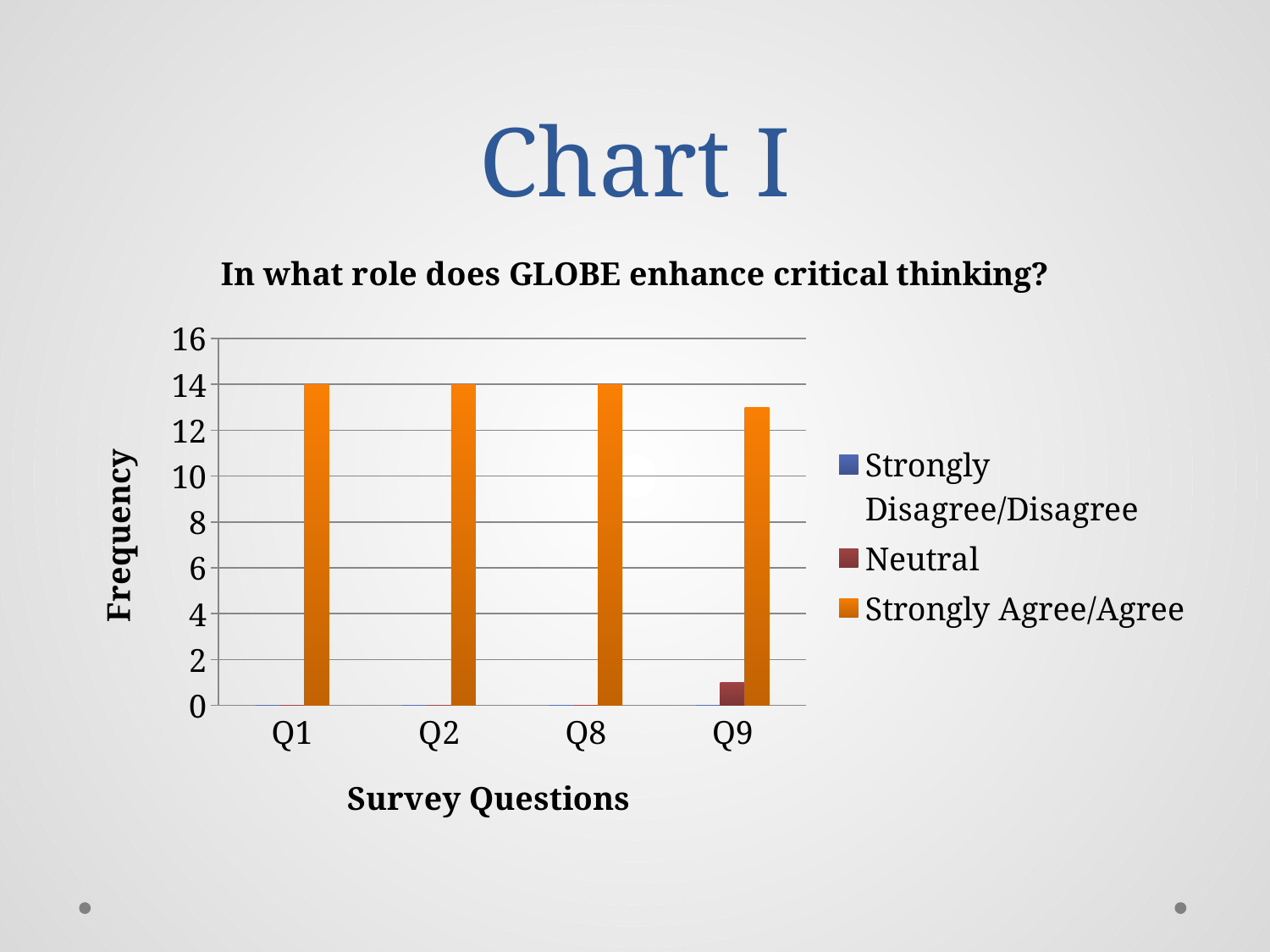
What is the label of the vertical axis? Frequency Is the Strongly Agree/Agree value for Q9 greater or less than 12? greater What kind of chart is shown on the slide? bar chart What is the title of the chart? In what role does GLOBE enhance critical thinking? Is the Strongly Agree/Agree value for Q9 greater or less than 14? less Which is larger, the Strongly Agree/Agree value for Q2 or for Q9? Q2 How many series does the legend list? 3 What is the Strongly Agree/Agree value for Q8? 14 Is the Neutral value for Q9 greater or less than 2? less How many survey questions are shown on the x axis? 4 What is the Strongly Agree/Agree value for Q1? 14 Which survey question has the lowest Strongly Agree/Agree value? Q9